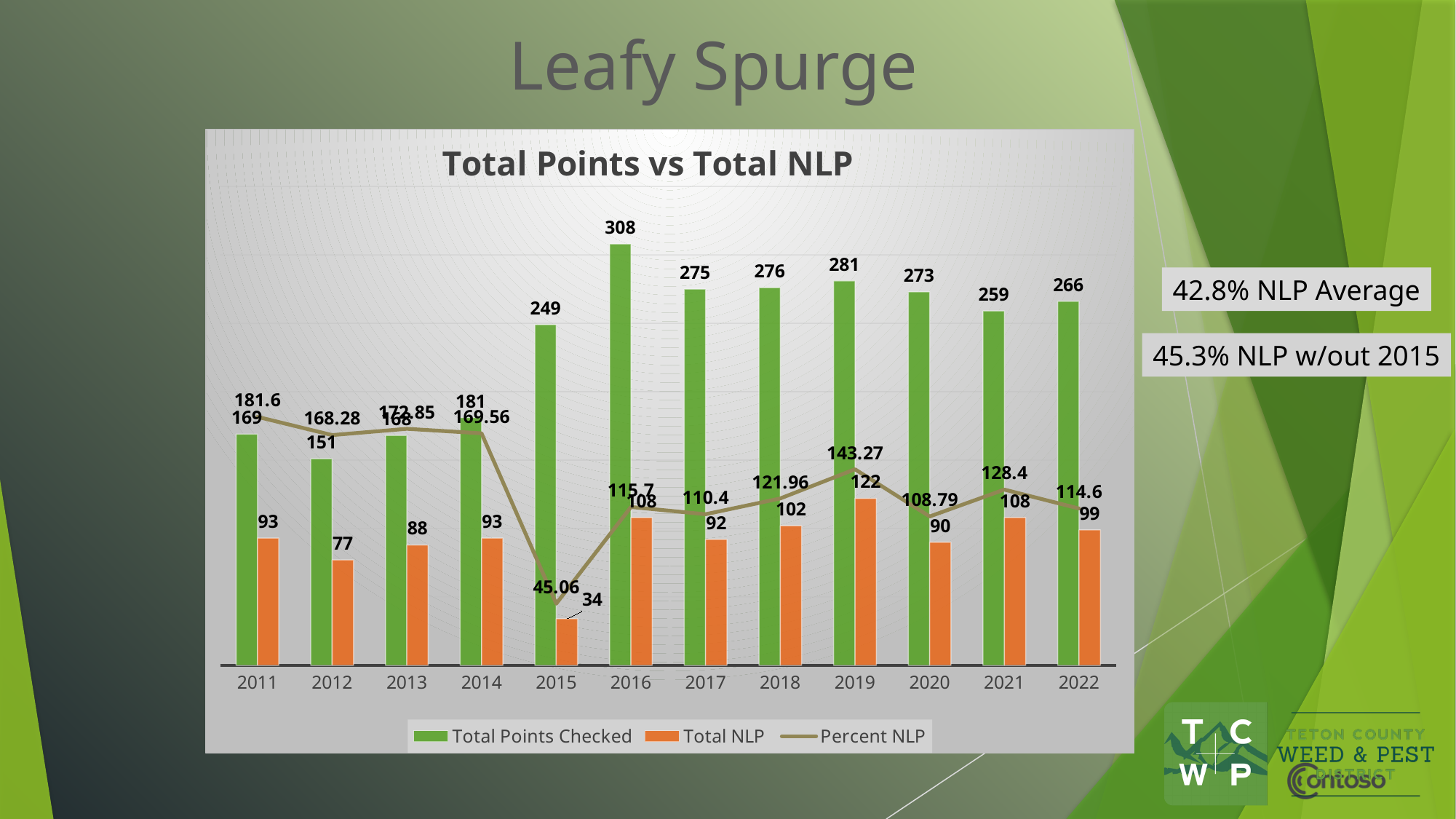
Which year has the larger Total NLP, 2018 or 2020? 2018 How many series does the legend list? 3 Which year has the highest Total Points Checked? 2016 What kind of chart is this? Bar chart with a line What is the difference between Total Points Checked and Total NLP in 2016? 200 What is the Total Points Checked value for 2016? 308 What is the Percent NLP value for 2015? 45.06 What is the Total NLP value for 2019? 122 Which year has the highest Percent NLP? 2011 What is the title of the chart? Total Points vs Total NLP How many years are shown on the x axis? 12 Which year has the lowest Total NLP? 2015